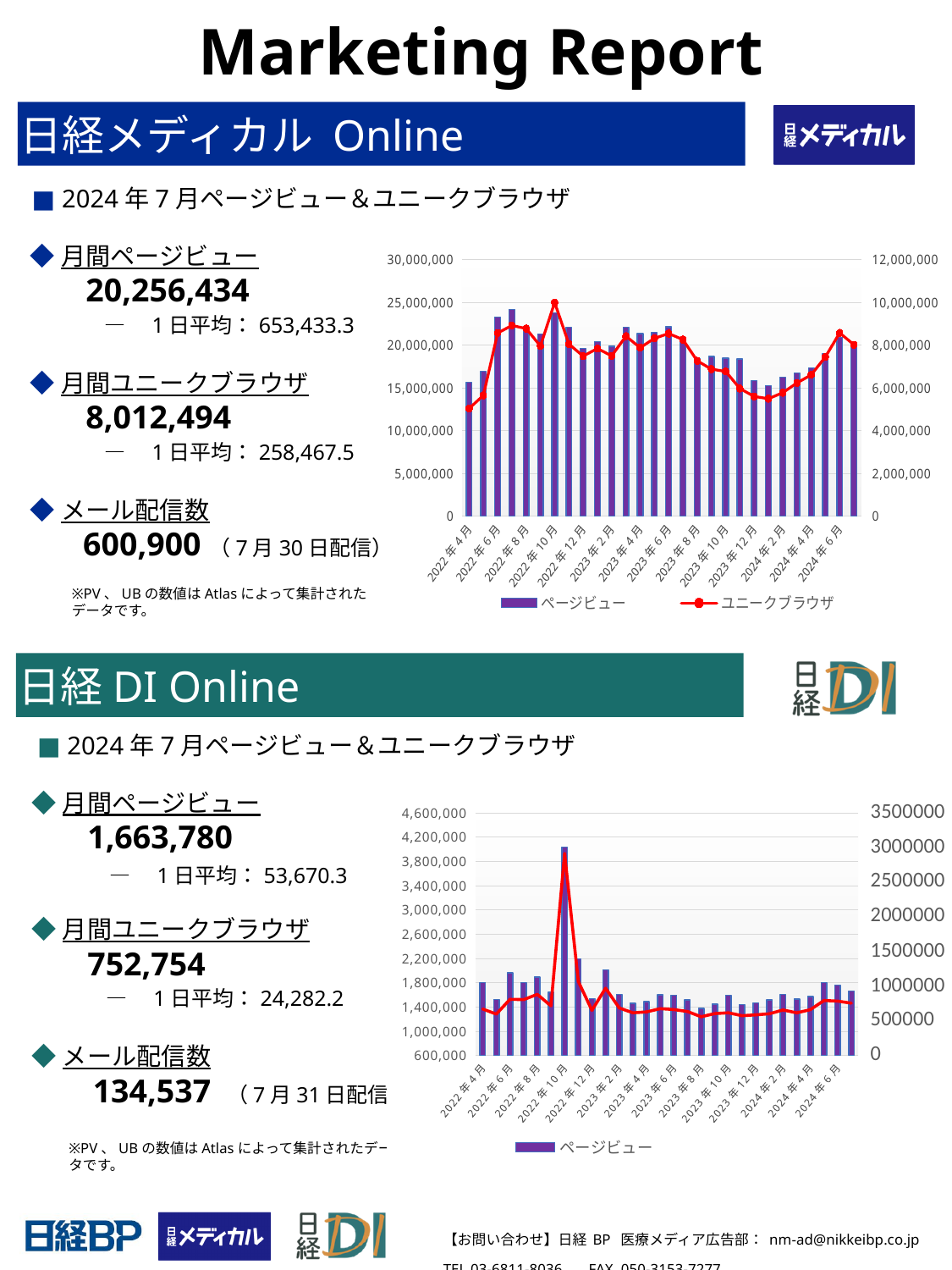
How many series does the legend of the 日経メディカル Online chart list? 2 In the 日経 DI Online chart, do the ページビュー bars rise or fall from 2022年10月 to 2022年12月? fall In the 日経 DI Online chart, which month has the highest ページビュー bar? 2022年10月 In the 日経メディカル Online chart, is the ユニークブラウザ value for 2022年10月 greater or less than 8,000,000? greater In the 日経メディカル Online chart, which is larger, the ページビュー bar for 2022年10月 or for 2022年4月? 2022年10月 In the 日経メディカル Online chart, what series is drawn as a red line? ユニークブラウザ In the 日経メディカル Online chart, is the ページビュー value for 2022年4月 greater or less than 20,000,000? less How many series does the legend of the 日経 DI Online chart list? 1 In the 日経 DI Online chart, is the ページビュー value for 2022年10月 greater or less than 3,000,000? greater What kind of chart is shown in the 日経メディカル Online section? A combined bar and line chart